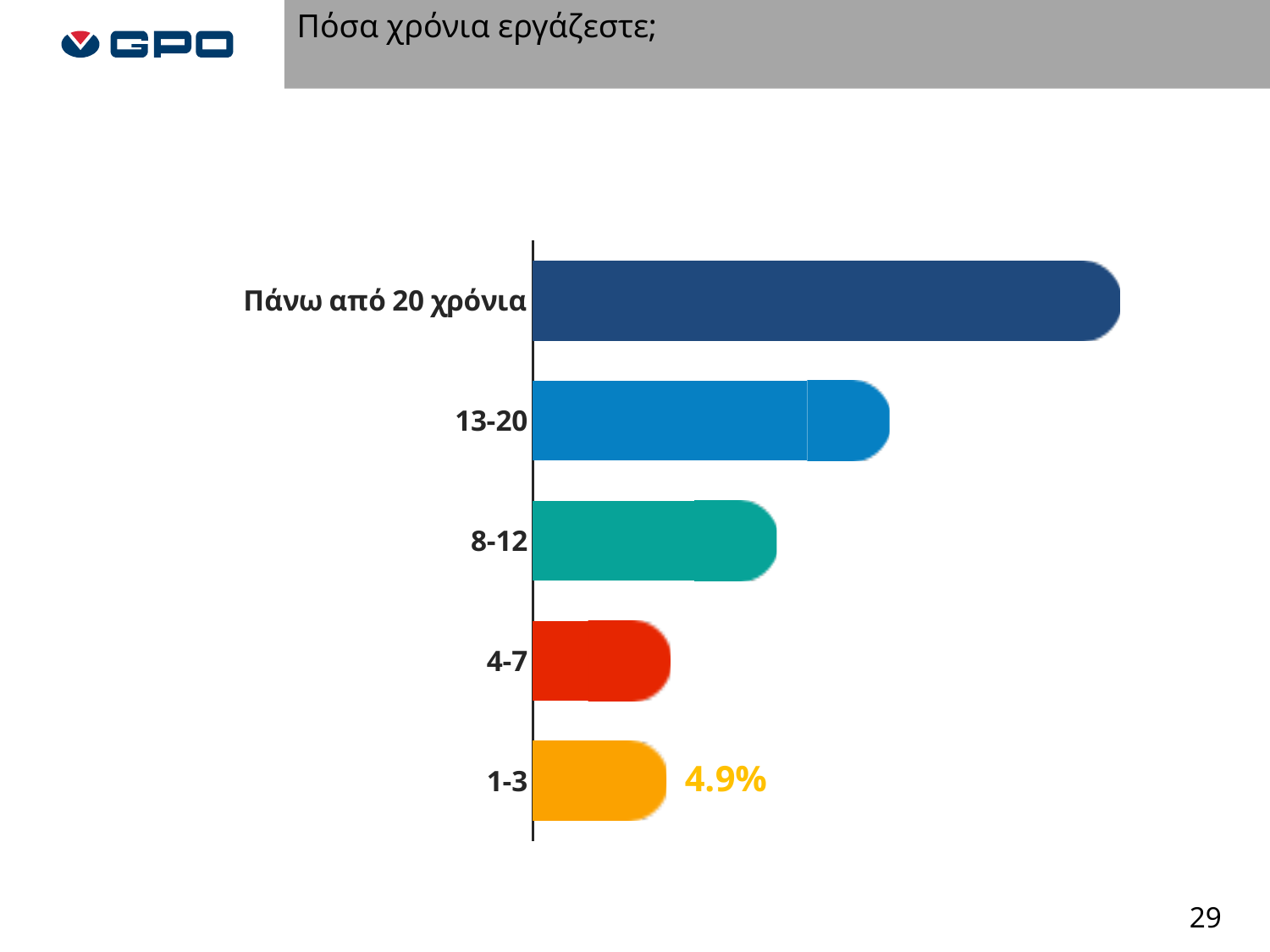
Which category has the only printed data label on the chart? 1-3 Which bar is longer, Πάνω από 20 χρόνια or 13-20? Πάνω από 20 χρόνια Which bar is longer, 13-20 or 8-12? 13-20 Which bar is longer, 8-12 or 4-7? 8-12 Which category has the longest bar? Πάνω από 20 χρόνια What is the title of the chart on the slide? Πόσα χρόνια εργάζεστε; Which category is listed at the top of the chart? Πάνω από 20 χρόνια What kind of chart is shown on the slide? bar chart What is the value shown for the category 1-3? 4.9% How many categories does the chart show? 5